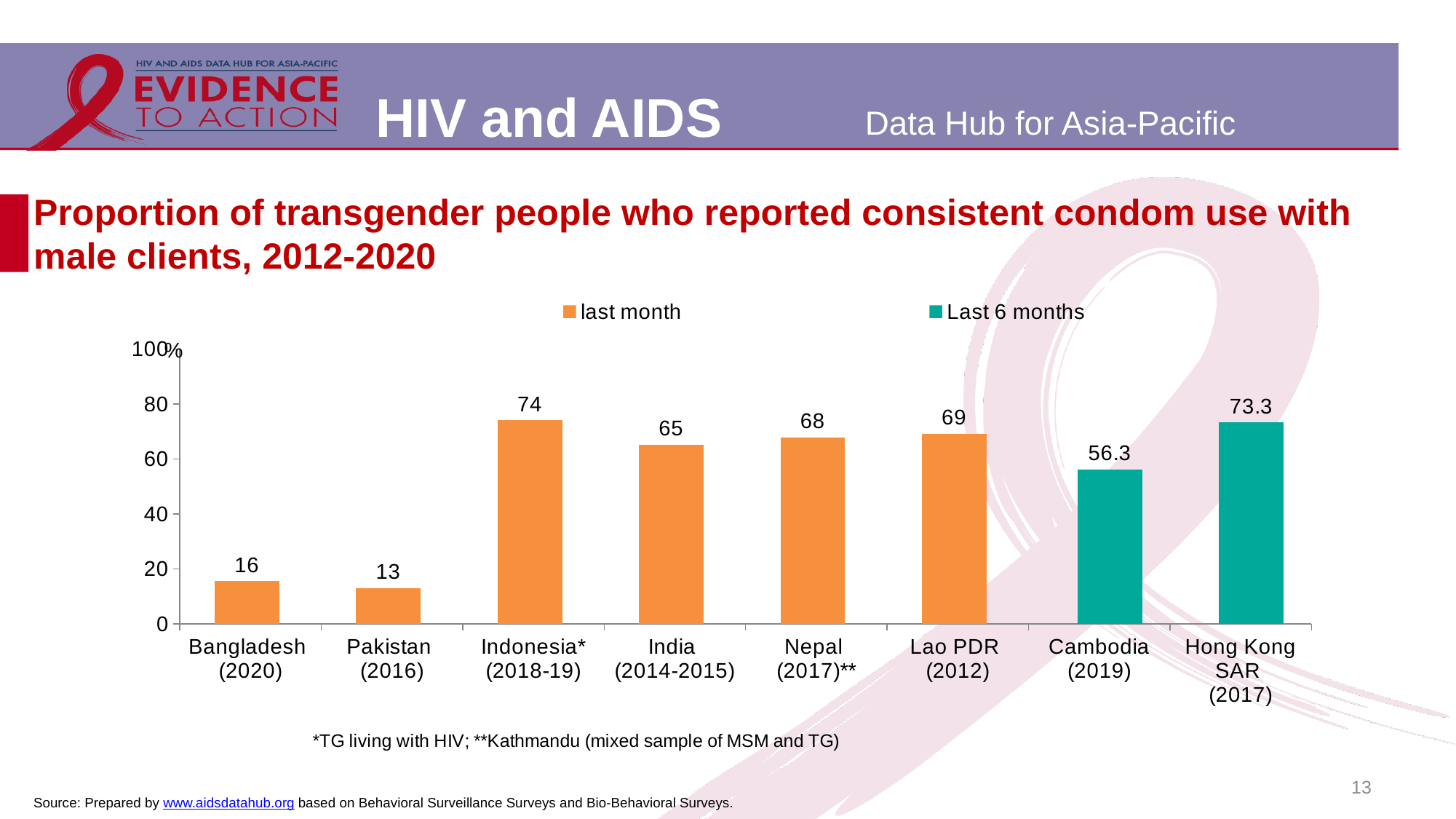
Which country has the highest value on the chart? Indonesia* (2018-19) What is the value for Indonesia* (2018-19)? 74 How many countries are shown on the chart? 8 What is the value for Cambodia (2019)? 56.3 How many series does the legend list? 2 Which series does the Hong Kong SAR (2017) bar belong to? Last 6 months What is the difference between the values for Lao PDR (2012) and India (2014-2015)? 4 Which country has the lowest value on the chart? Pakistan (2016) What kind of chart is shown on the slide? bar chart Is the value for Hong Kong SAR (2017) greater or less than 60? greater Which is larger, the value for Nepal (2017)** or the value for Cambodia (2019)? Nepal (2017)** What is the value for Bangladesh (2020)? 16